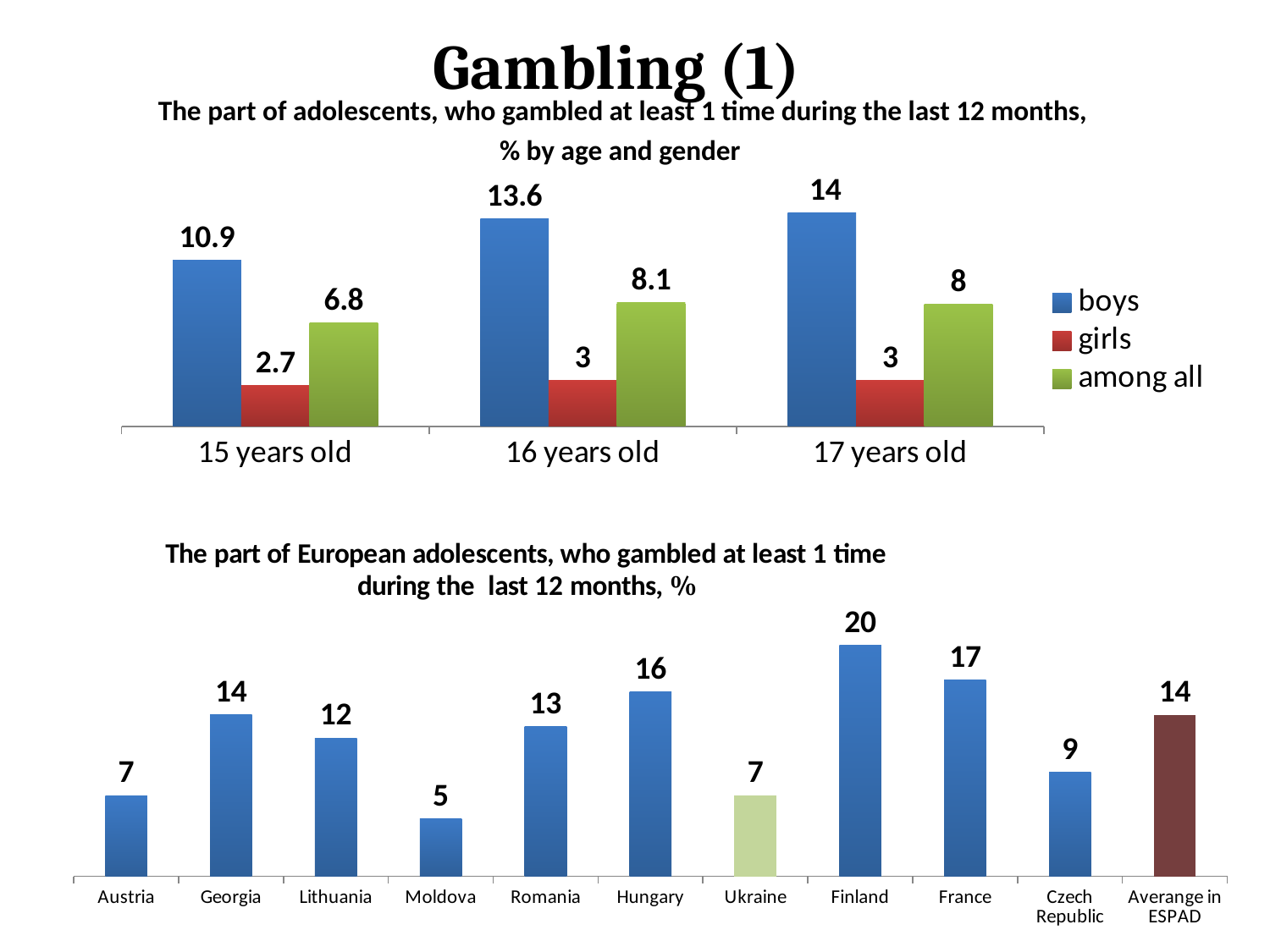
In the top chart (% by age and gender), what is the difference between boys and girls at 15 years old? 8.2 In the top chart (% by age and gender), what is the value for girls at 16 years old? 3 In the bottom chart (European adolescents), what is the value for Ukraine? 7 In the top chart (% by age and gender), what is the value for boys at 15 years old? 10.9 In the bottom chart (European adolescents), which is larger, Hungary or Romania? Hungary In the top chart (% by age and gender), how many series does the legend list? 3 What kind of chart is the bottom chart (European adolescents)? bar chart In the bottom chart (European adolescents), which country has the highest value? Finland In the top chart (% by age and gender), what is the value for 'among all' at 17 years old? 8 In the bottom chart (European adolescents), which country has the lowest value? Moldova In the top chart (% by age and gender), do the values for boys rise or fall from 15 years old to 17 years old? rise In the bottom chart (European adolescents), what is the difference between Finland and France? 3